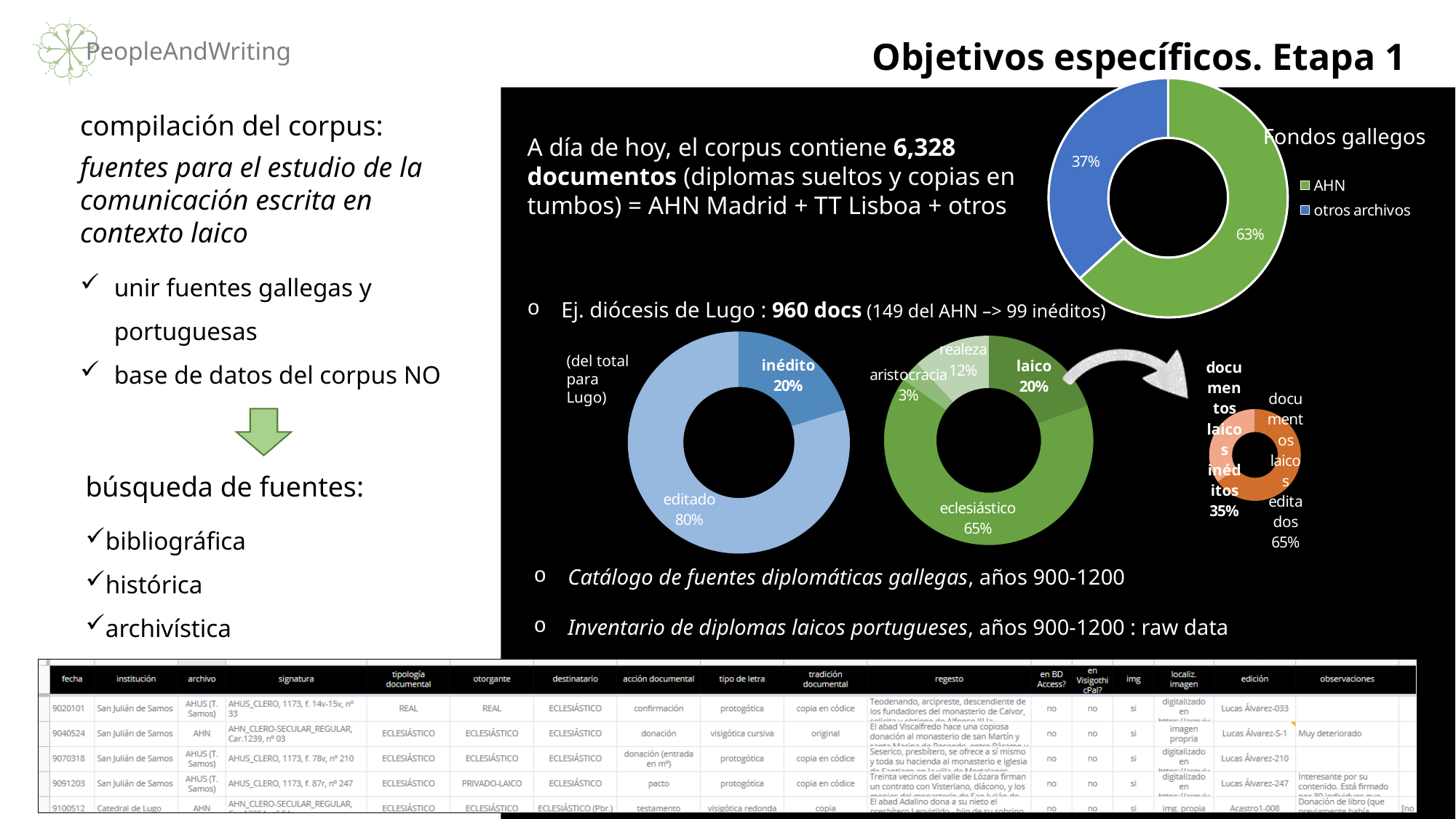
In the blue donut chart for Lugo, what is the difference between the 'editado' and 'inédito' shares? 60% In the blue donut chart for Lugo, what share is 'editado'? 80% In the 'Fondos gallegos' chart, what share is AHN? 63% What kind of chart is the 'Fondos gallegos' chart? Donut (pie) chart In the 'Fondos gallegos' chart, what share is 'otros archivos'? 37% In the orange donut chart on the right, what share is 'documentos laicos inéditos'? 35% In the green donut chart for Lugo, what share is 'eclesiástico'? 65% In the 'Fondos gallegos' chart, which category has the larger share? AHN In the 'Fondos gallegos' chart, how many entries does the legend list? 2 In the green donut chart for Lugo, which category has the smallest share? aristocracia In the green donut chart for Lugo, how many categories are shown? 4 In the blue donut chart for Lugo, what share is 'inédito'? 20%